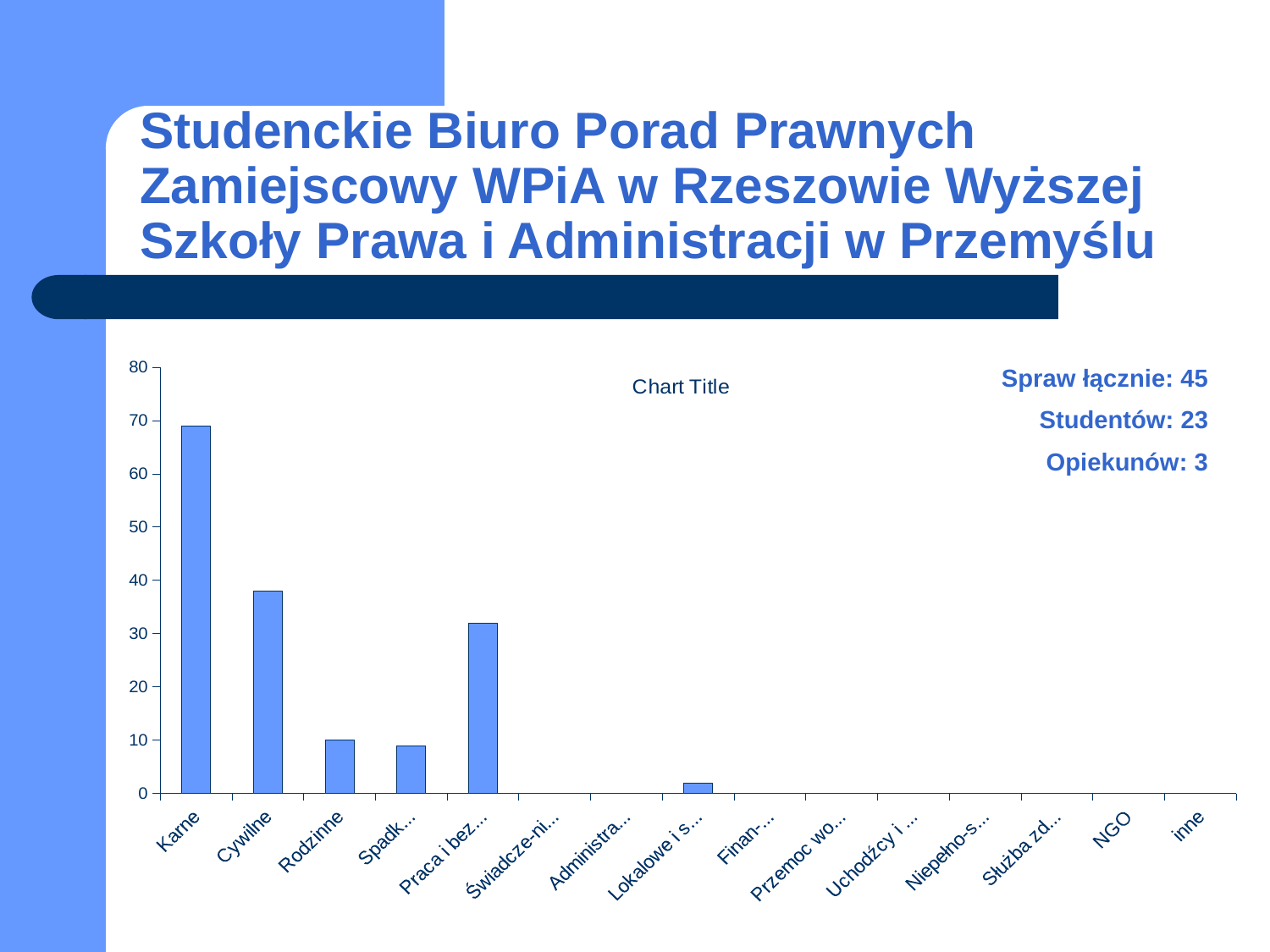
Is the value for Cywilne greater or less than 40? less Which category has the highest bar in the chart? Karne Is the value for Karne greater or less than 60? greater Is the value for Lokalowe i s... greater or less than 10? less Which is larger, the value for Rodzinne or the value for Karne? Karne How many categories are shown on the x axis of the chart? 15 Which is larger, the value for Cywilne or the value for Praca i bez...? Cywilne What kind of chart is shown on the slide? bar chart What is the title printed on the chart? Chart Title What is the highest value shown on the chart's vertical axis? 80